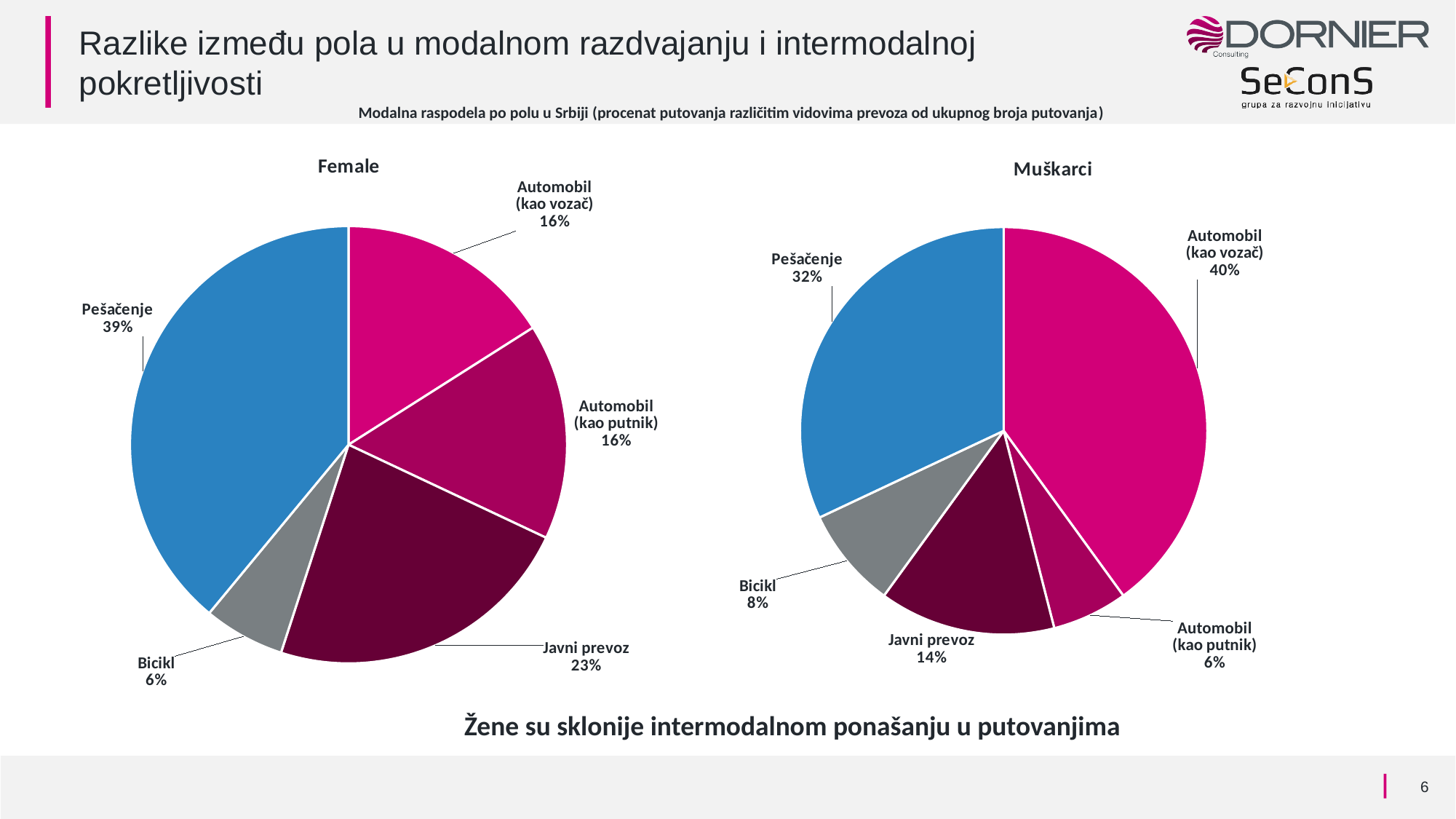
In the Female pie chart, which category has the largest share? Pešačenje In the Female pie chart, what is the difference between Javni prevoz and Bicikl? 17% In the Muškarci pie chart, what is the difference between Automobil (kao vozač) and Pešačenje? 8% In the Muškarci pie chart, which category has the smallest share? Automobil (kao putnik) In the Female pie chart, which category has the smallest share? Bicikl In the Muškarci pie chart, what share of trips is Bicikl? 8% What type of chart is used on this slide? Pie chart What is the title of the chart on the right? Muškarci In the Female pie chart, what share of trips is Pešačenje? 39% How many slices does the Female pie chart have? 5 In the Muškarci pie chart, what share of trips is Automobil (kao vozač)? 40% Which is larger: Javni prevoz in the Female chart or Javni prevoz in the Muškarci chart? Female